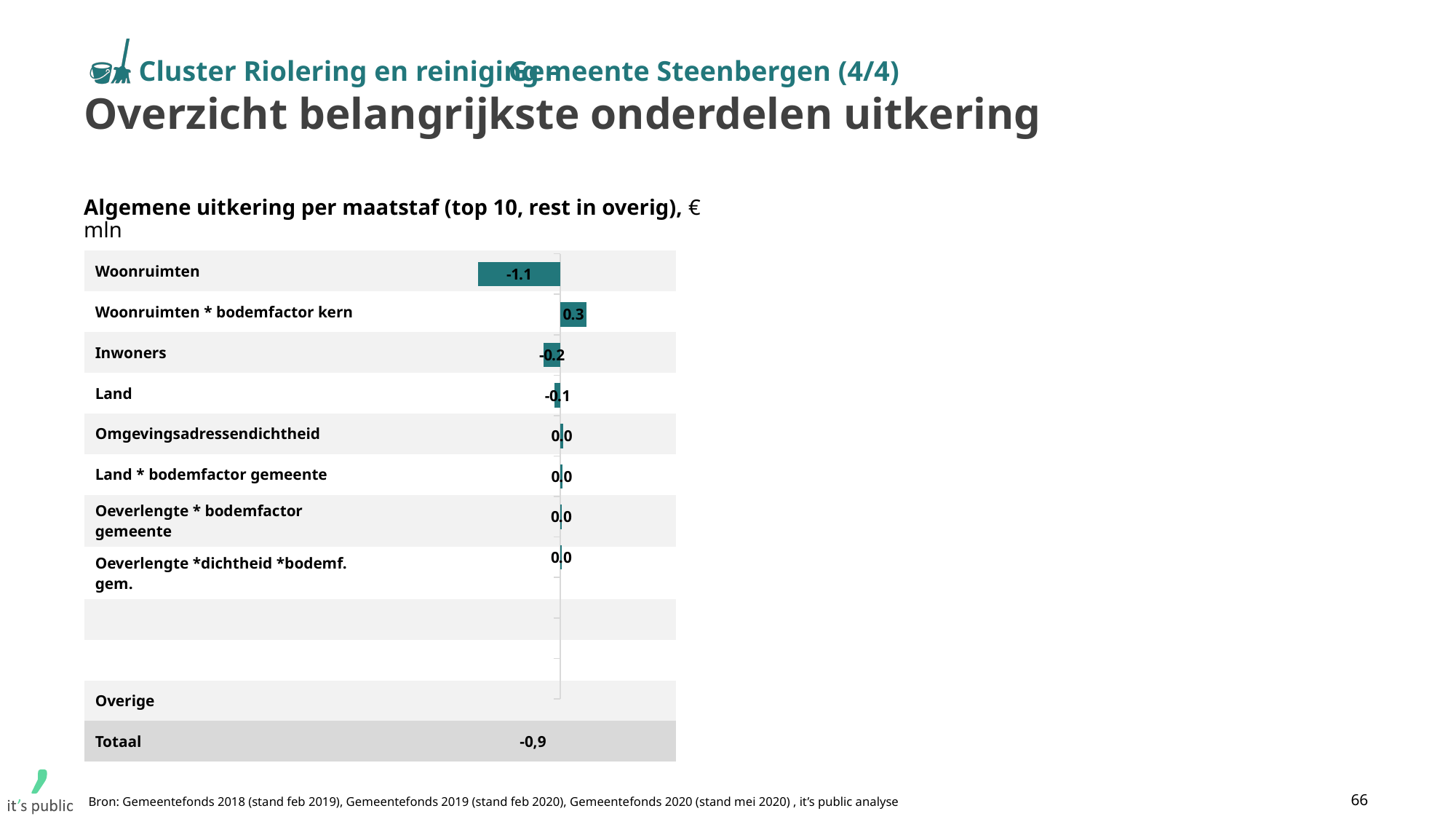
What is the value for Land? -0.1 What is the Totaal value shown at the bottom of the chart? -0,9 What is the value for Inwoners? -0.2 Which category has the lowest (most negative) value? Woonruimten What is the unit stated in the chart title? € mln What is the difference between the values for Woonruimten * bodemfactor kern and Inwoners? 0.5 What is the value for Woonruimten * bodemfactor kern? 0.3 Which category has the highest value? Woonruimten * bodemfactor kern What is the value for Omgevingsadressendichtheid? 0.0 What is the value for Woonruimten? -1.1 Which is larger, the value for Inwoners or the value for Land? Land What kind of chart is shown on the slide? Bar chart